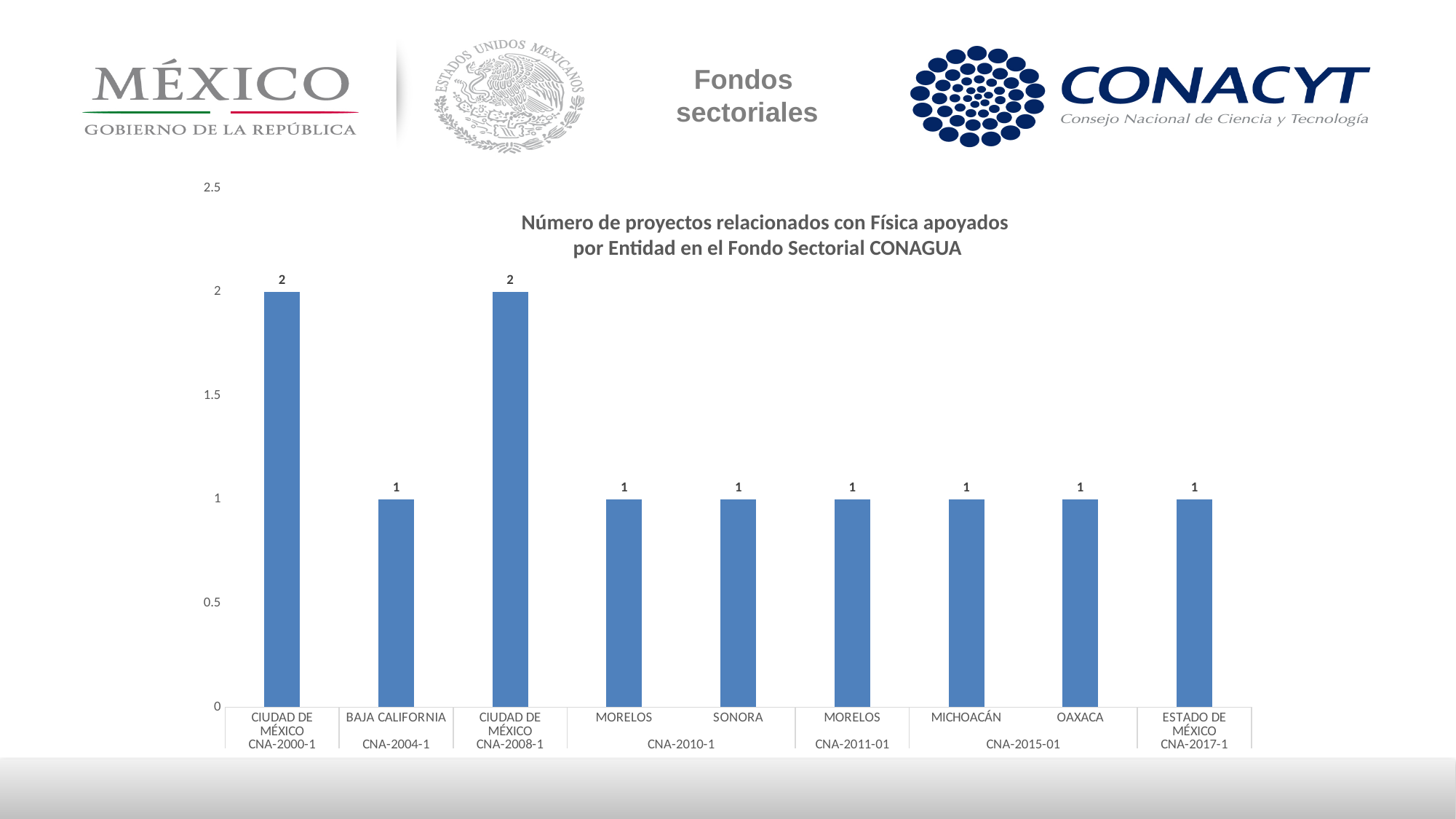
How many projects are shown for Ciudad de México under CNA-2000-1? 2 How many projects are shown for Ciudad de México under CNA-2008-1? 2 What is the difference between the value for Ciudad de México (CNA-2000-1) and the value for Baja California (CNA-2004-1)? 1 What type of chart is shown on the slide? bar chart How many projects are shown for Estado de México under CNA-2017-1? 1 What is the total number of projects across all bars in the chart? 11 How many bars are plotted in the chart? 9 Which entity has the highest number of projects in the chart? Ciudad de México What is the combined number of projects for Morelos and Sonora under CNA-2010-1? 2 Which is larger: the value for Ciudad de México (CNA-2008-1) or the value for Sonora (CNA-2010-1)? Ciudad de México (CNA-2008-1) How many projects are shown for Baja California under CNA-2004-1? 1 What is the title of the chart? Número de proyectos relacionados con Física apoyados por Entidad en el Fondo Sectorial CONAGUA